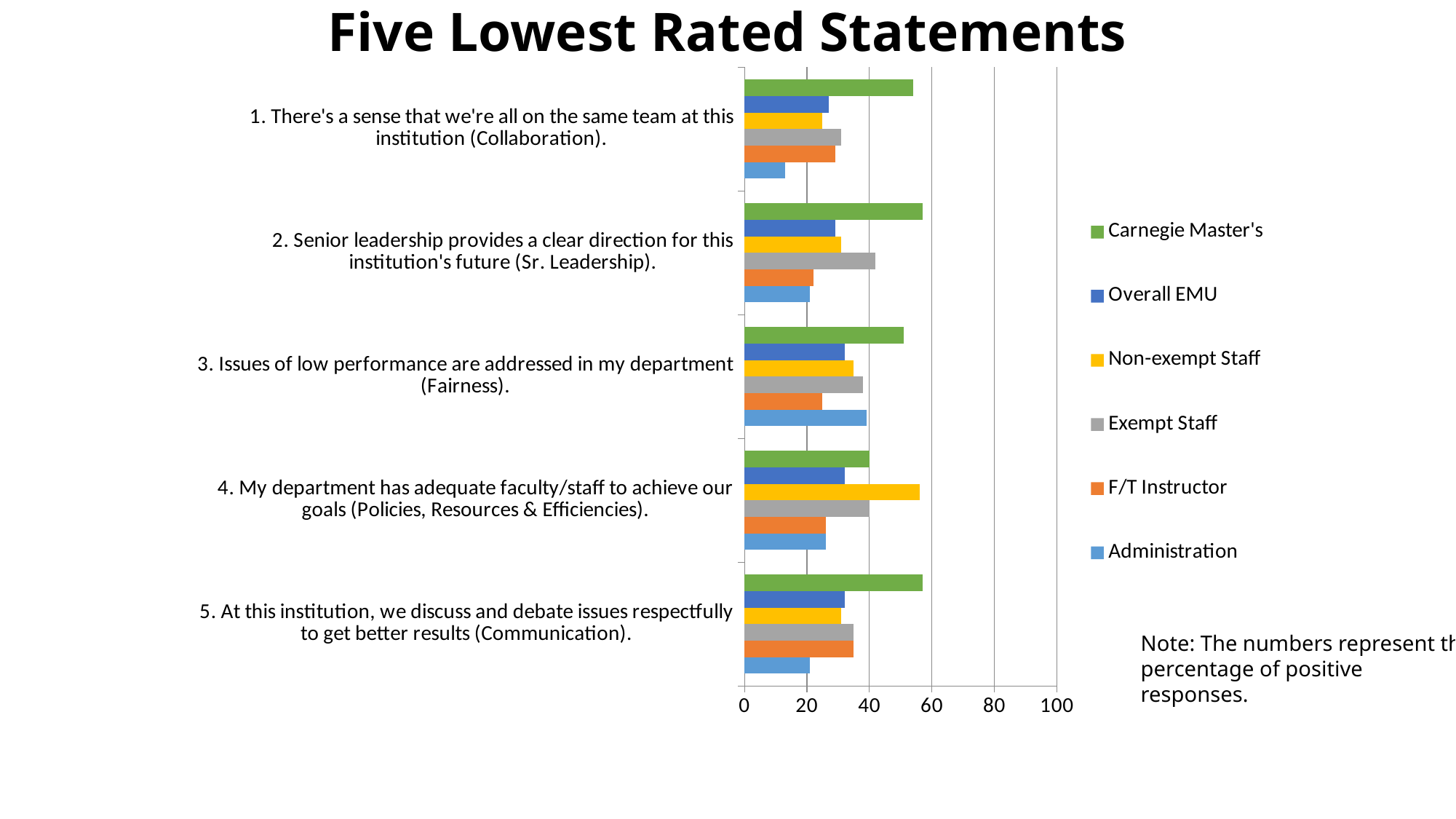
Is the Administration value for statement 5 (Communication) greater or less than 40? less How many statements are plotted on the chart? 5 How many series does the legend list? 6 For statement 4 (Policies, Resources & Efficiencies), which group has the highest value? Non-exempt Staff For statement 2 (Sr. Leadership), which is larger: Exempt Staff or F/T Instructor? Exempt Staff For statement 3 (Fairness), which is larger: Administration or F/T Instructor? Administration Is the Carnegie Master's value for statement 2 (Sr. Leadership) greater or less than 40? greater Is the Administration value for statement 1 (Collaboration) greater or less than 20? less What kind of chart is shown on the slide? Bar chart What is the title of the chart? Five Lowest Rated Statements For statement 1 (Collaboration), which group has the lowest value? Administration